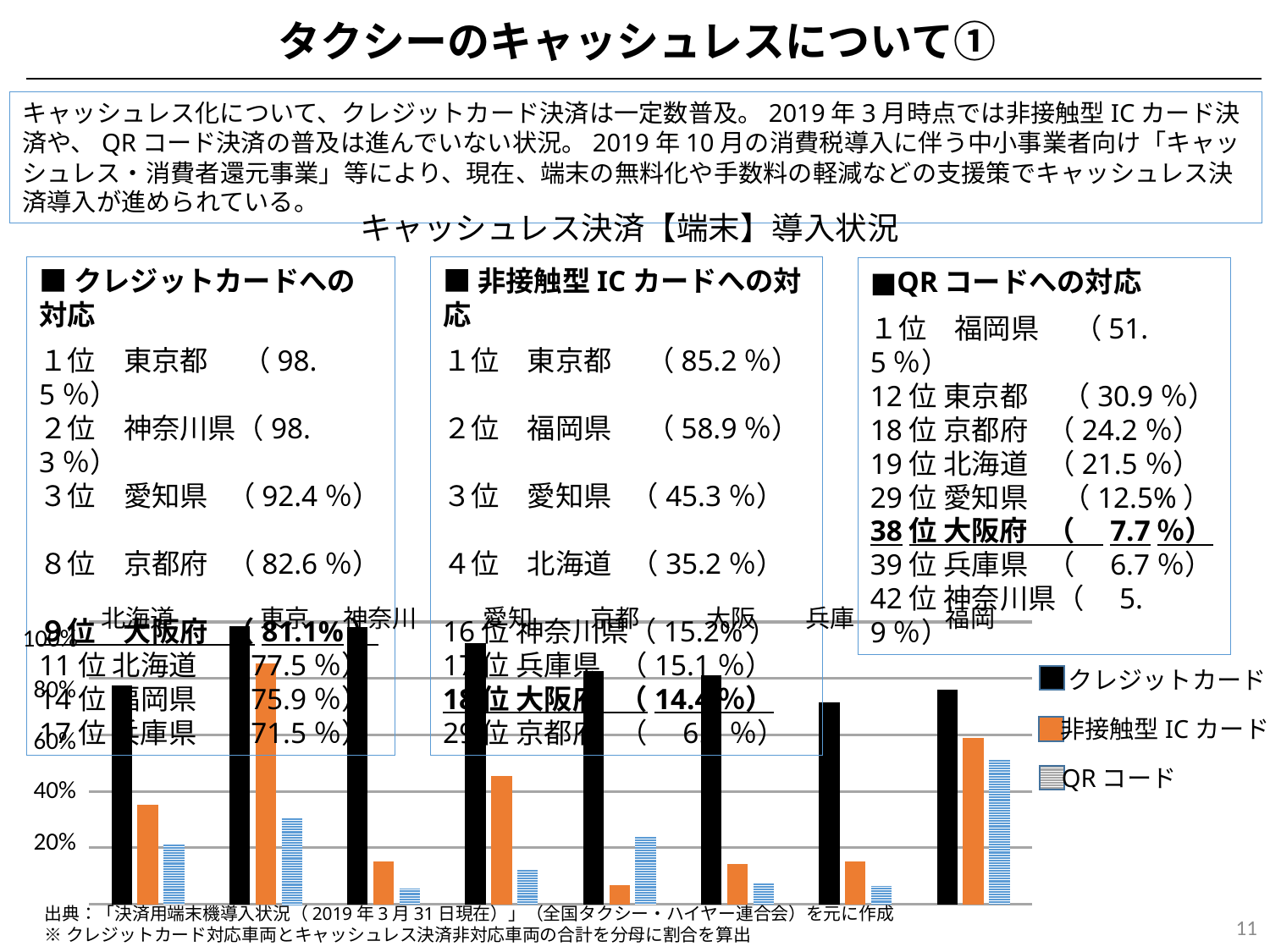
Is the QRコード value for 東京 greater or less than 40%? less Which prefecture has the lowest 非接触型ICカード value in the chart? 京都 What kind of chart is shown at the bottom of the slide? bar chart Which prefecture has the highest 非接触型ICカード value in the chart? 東京 Which prefecture has the highest QRコード value in the chart? 福岡 Is the QRコード value for 福岡 greater or less than 40%? greater Which legend entry is shown in orange? 非接触型ICカード How many prefectures (categories) are plotted along the x axis of the chart? 8 How many series does the chart legend list? 3 For 東京, which is larger: the 非接触型ICカード value or the QRコード value? 非接触型ICカード Is the クレジットカード value for 北海道 greater or less than 60%? greater